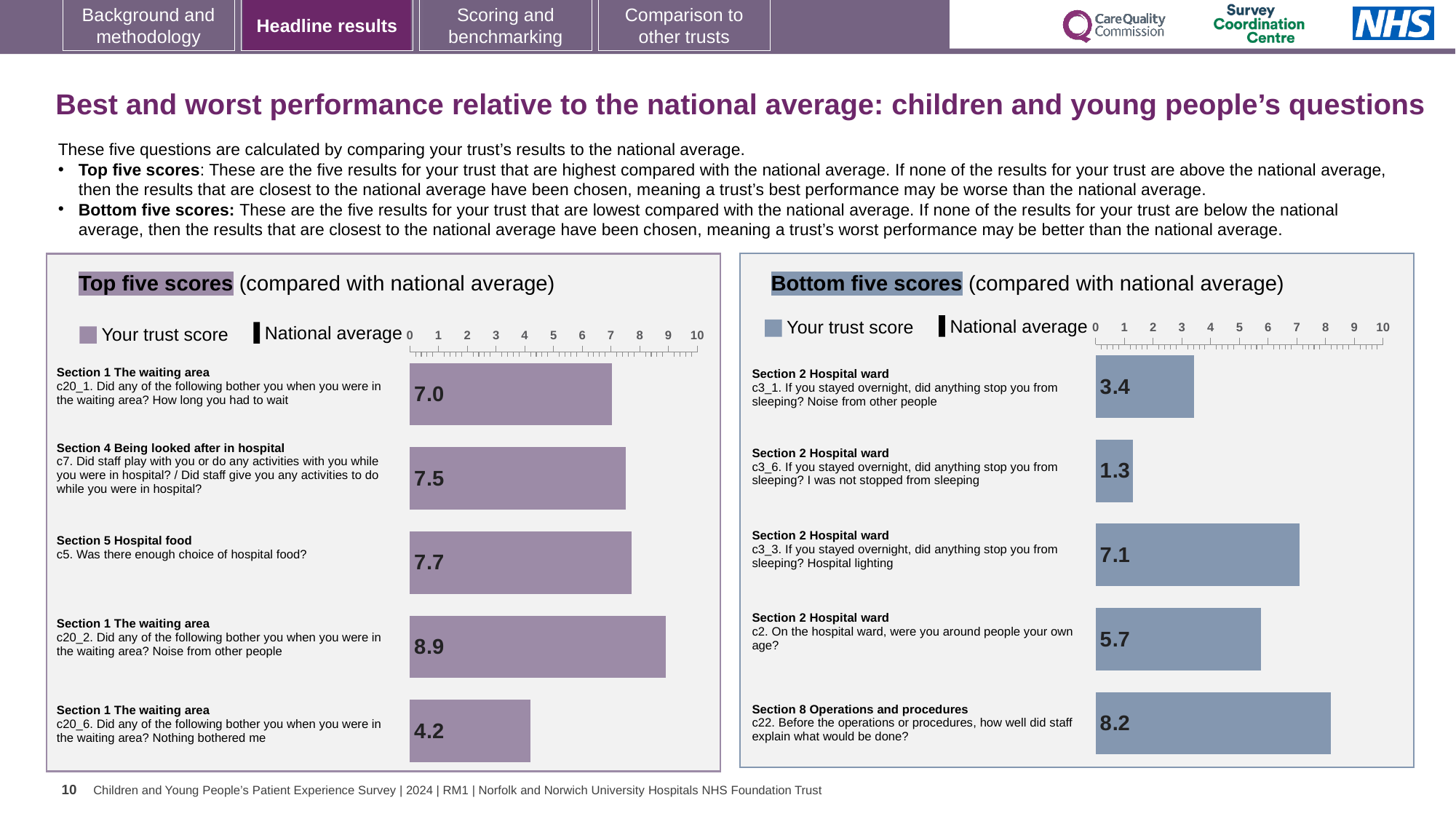
In the Bottom five scores chart, what is the difference between the trust scores for c22 (8.2) and c3_1 (Noise from other people)? 4.8 In the Top five scores chart, what is the trust score for c5 'Was there enough choice of hospital food?' 7.7 How many series does the legend of the Bottom five scores chart list? 2 In the Top five scores chart, what is the trust score for c20_6 'Nothing bothered me' in the waiting area? 4.2 In the Top five scores chart, how many questions are plotted? 5 In the Bottom five scores chart, which question has the lowest trust score? c3_6. I was not stopped from sleeping In the Bottom five scores chart, what is the trust score for c3_6 'I was not stopped from sleeping'? 1.3 What kind of chart is used in the Top five scores panel? Bar chart In the Bottom five scores chart, is the trust score for c3_3 (Hospital lighting) or c2 (around people your own age) larger? c3_3 (Hospital lighting) In the Top five scores chart, which question has the highest trust score? c20_2. Noise from other people (waiting area) In the Top five scores chart, what is the difference between the trust scores for c20_2 (Noise from other people) and c20_1 (How long you had to wait)? 1.9 In the Bottom five scores chart, what is the trust score for c22 'how well did staff explain what would be done?' 8.2